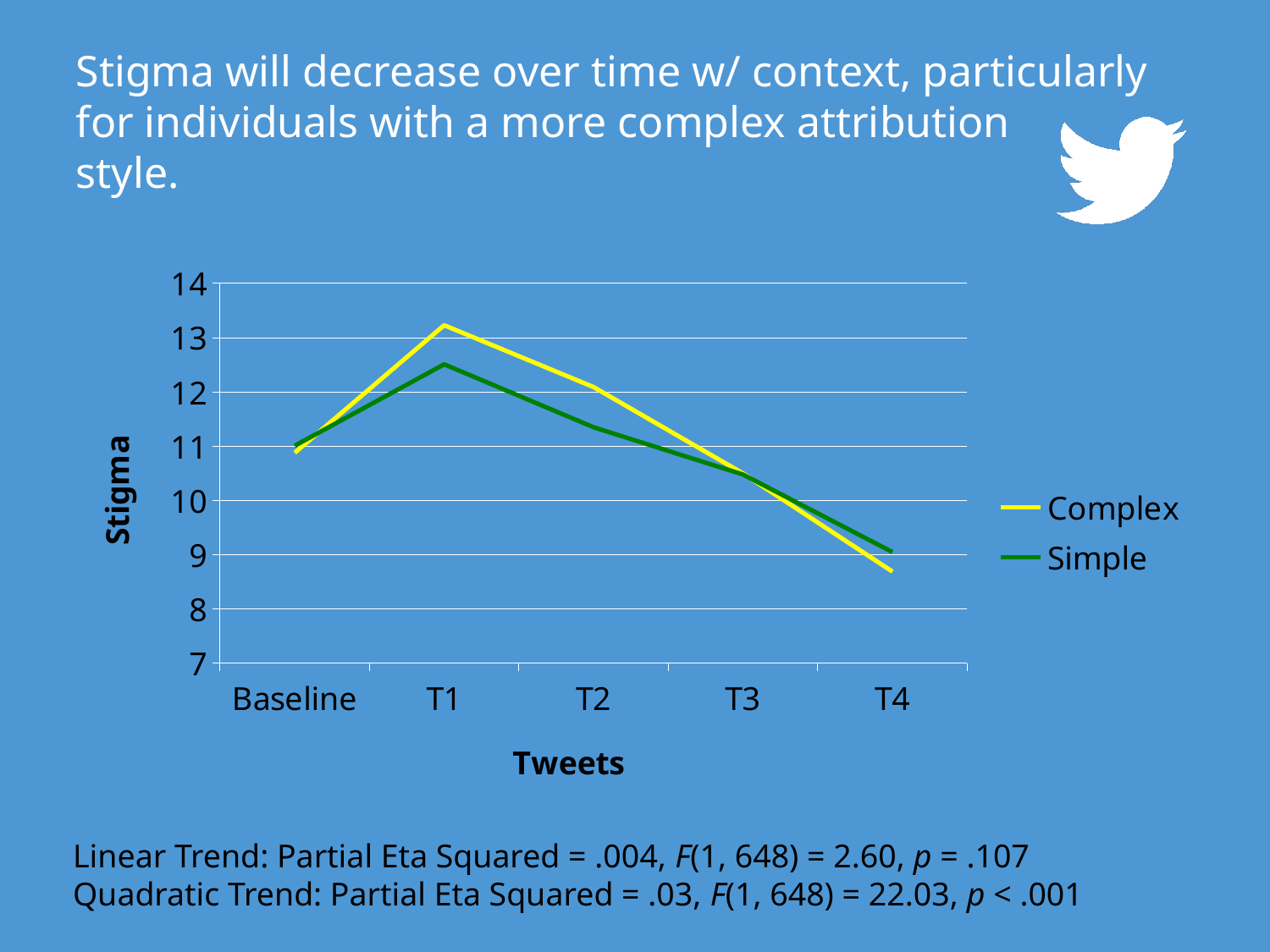
Is the value for Complex at T1 greater or less than 13? greater How many points are plotted along the x axis for each series? 5 Is the value for Simple at T4 greater or less than 10? less What is the title of the x axis? Tweets At which point on the x axis does the Complex series reach its highest value? T1 At T1, which series has the larger value, Complex or Simple? Complex At which point on the x axis does the Simple series reach its highest value? T1 Does the Complex series rise or fall from T1 to T4? fall At T4, which series has the larger value, Complex or Simple? Simple What kind of chart is shown on the slide? line chart How many series does the legend list? 2 At which point on the x axis is the Complex series lowest? T4